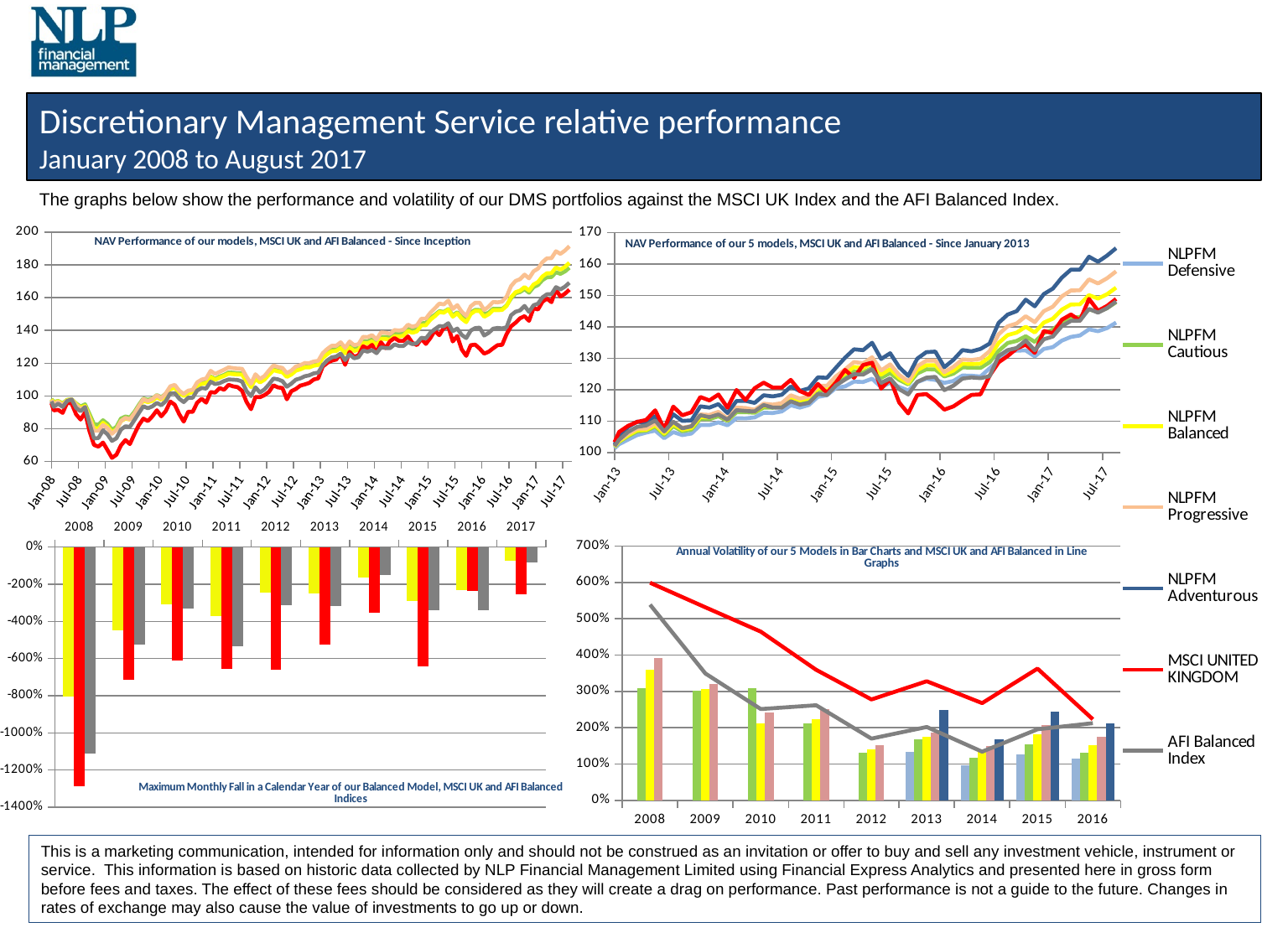
In the top-left 'NAV Performance ... Since Inception' chart, is the red MSCI UK line at its low point around Jan-09 greater or less than 80? less In the bottom-right 'Annual Volatility' chart, is the MSCI UK line value for 2008 greater or less than 500%? greater What kind of chart is the bottom-left chart titled 'Maximum Monthly Fall in a Calendar Year of our Balanced Model, MSCI UK and AFI Balanced Indices'? bar chart In the bottom-right 'Annual Volatility' chart, does the red MSCI UK line overall rise or fall from 2008 to 2016? fall In the top-right 'NAV Performance ... Since January 2013' chart, is the NLPFM Adventurous value at Jul-17 greater or less than 160? greater In the bottom-right 'Annual Volatility' chart, how many years are shown on the x axis? 9 In the top-right 'NAV Performance ... Since January 2013' chart, which series is highest at Jul-17? NLPFM Adventurous What kind of chart is the top-left chart titled 'NAV Performance of our models, MSCI UK and AFI Balanced - Since Inception'? line chart In the bottom-left 'Maximum Monthly Fall' chart, which year has the lowest (largest negative) bar? 2008 In the bottom-left 'Maximum Monthly Fall' chart, how many calendar years are shown on the x axis? 10 How many series does the legend on the right of the slide list? 7